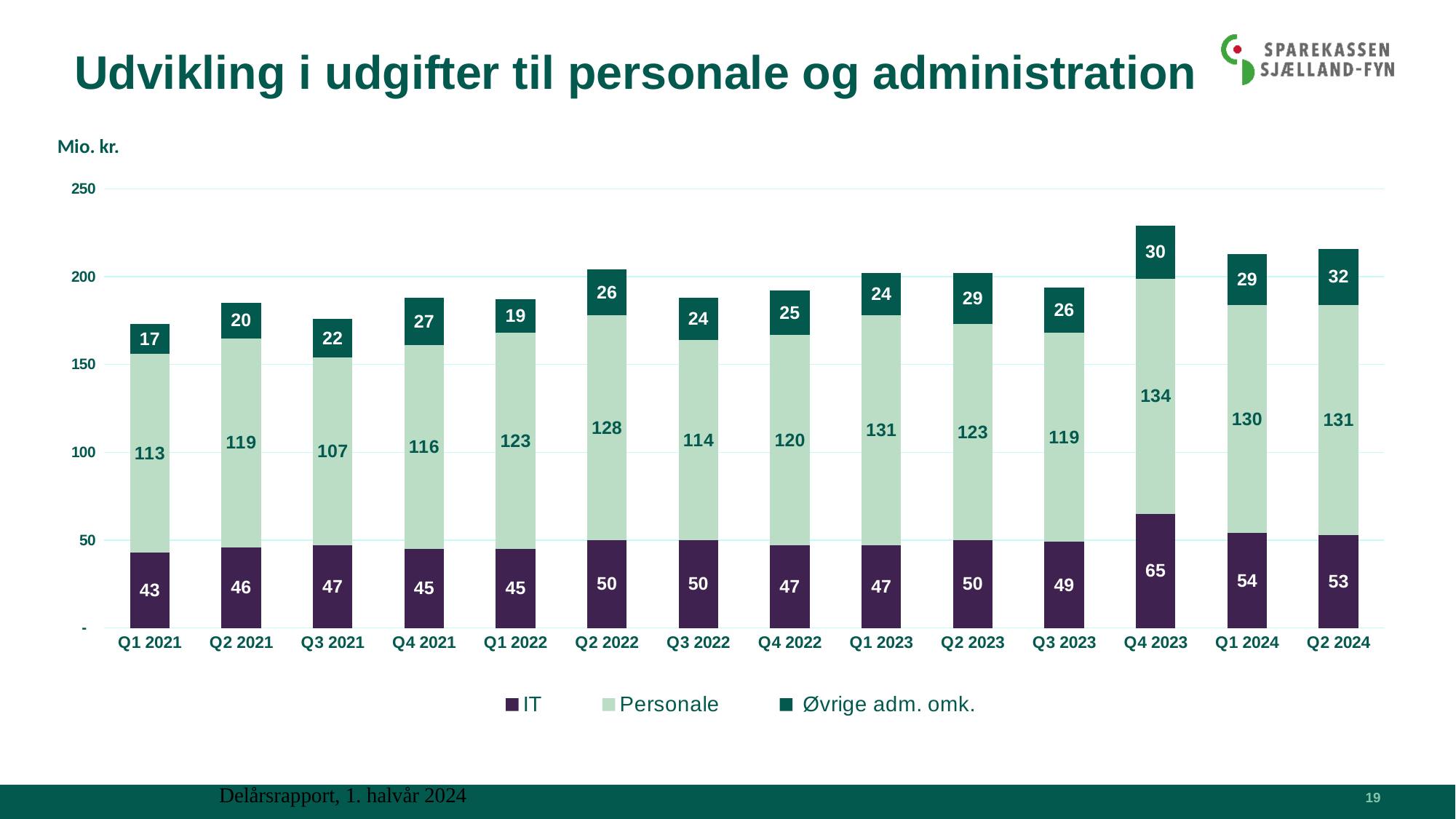
What is the Personale value for Q2 2022? 128 What is the total of the stacked bar for Q4 2023? 229 Which quarter has the highest Personale value? Q4 2023 How many quarters are shown on the x axis? 14 What kind of chart is shown on the slide? Stacked bar chart How many series does the legend list? 3 What is the Øvrige adm. omk. value for Q2 2024? 32 Which quarter has the lowest Øvrige adm. omk. value? Q1 2021 Which is larger, the Personale value for Q1 2023 or for Q2 2023? Q1 2023 What is the difference between the IT value in Q4 2023 and the IT value in Q1 2024? 11 What is the IT value for Q4 2023? 65 What is the total of the stacked bar for Q1 2021? 173